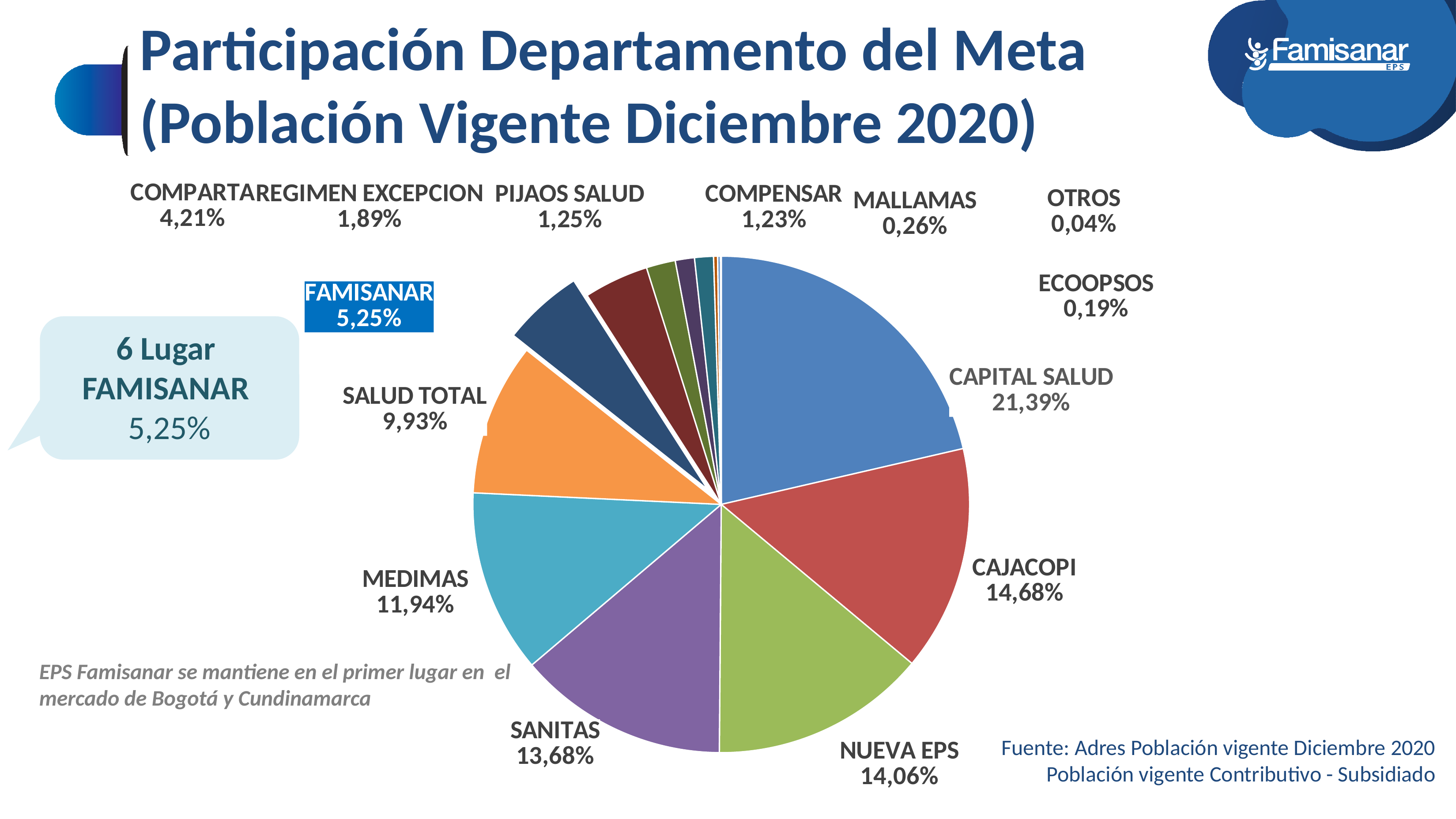
What is the share for FAMISANAR? 5,25% Which has a larger share, SALUD TOTAL or FAMISANAR? SALUD TOTAL What is the difference in percentage points between SANITAS and MEDIMAS? 1,74 What kind of chart is shown on the slide? pie chart What is the title of the slide containing the chart? Participación Departamento del Meta (Población Vigente Diciembre 2020) What is the share for CAPITAL SALUD? 21,39% How many categories are shown in the pie chart? 14 What is the share for MEDIMAS? 11,94% What is the share for ECOOPSOS? 0,19% Which category has the smallest slice of the pie? OTROS What is the difference in percentage points between CAPITAL SALUD and CAJACOPI? 6,71 Which category has the largest slice of the pie? CAPITAL SALUD